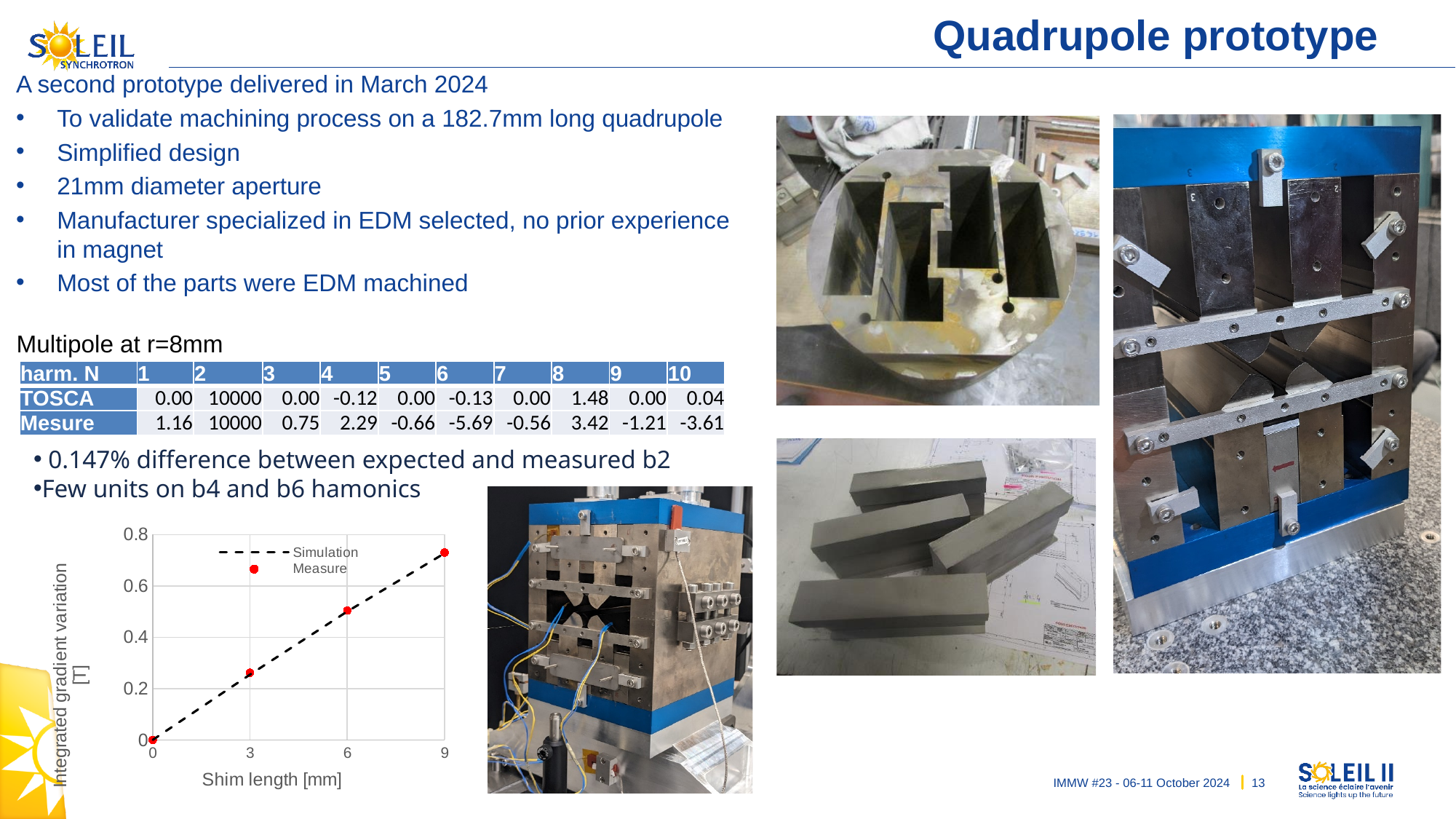
At which shim length is the measured integrated gradient variation lowest? 0 mm At which shim length is the measured integrated gradient variation highest? 9 mm What kind of chart is shown on the slide? line chart Which is larger, the measured value at 9 mm shim length or at 6 mm shim length? 9 mm What are the two series named in the chart legend? Simulation and Measure How many series does the chart legend list? 2 How many measured points are plotted on the chart? 4 Does the integrated gradient variation rise or fall as shim length increases? rises Is the measured value at a shim length of 3 mm greater or less than 0.4? less What is the label of the x axis of the chart? Shim length [mm] Is the measured value at a shim length of 6 mm greater or less than 0.4? greater What is the measured integrated gradient variation at a shim length of 0 mm? 0